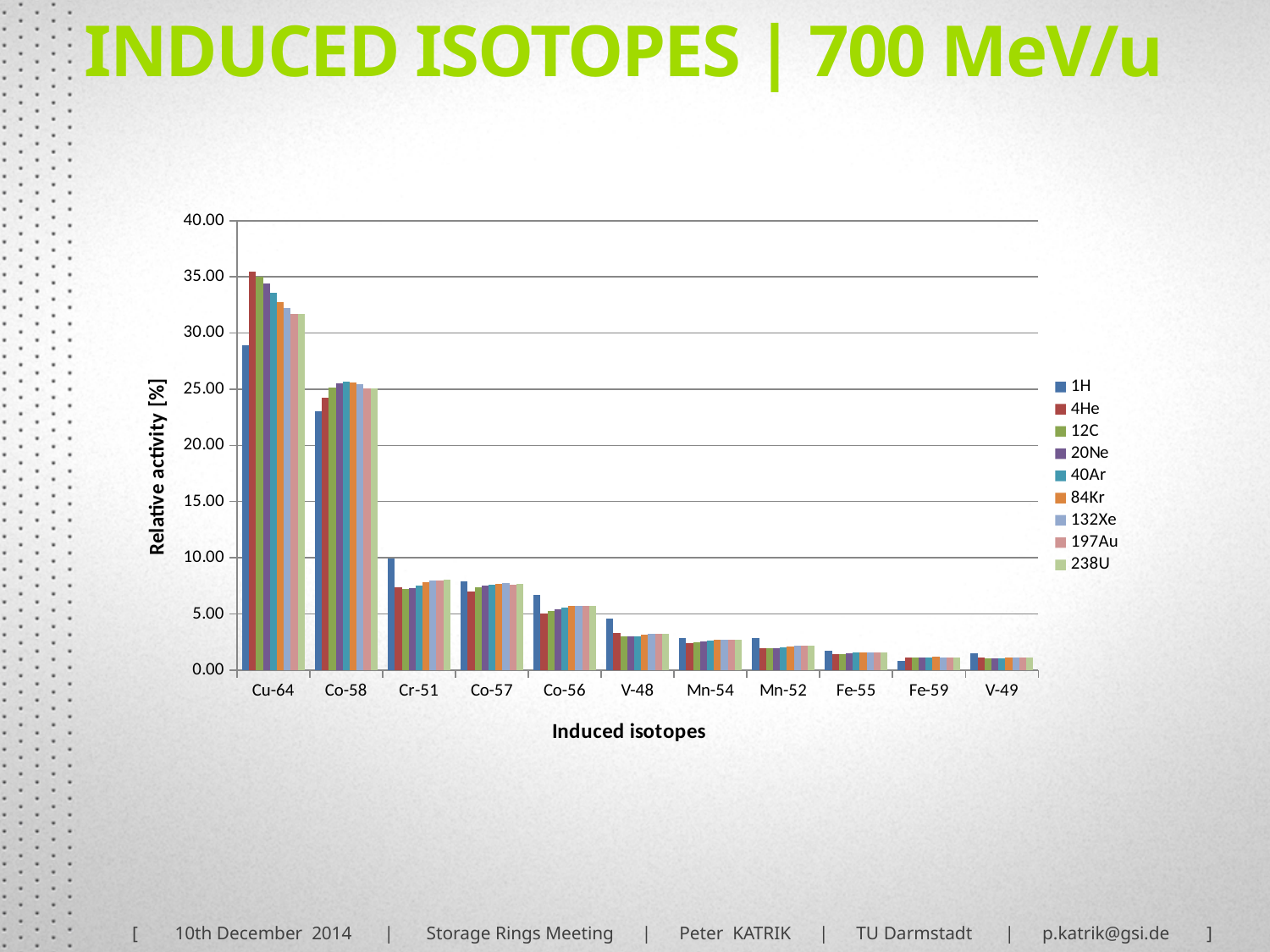
Is the relative activity of Cr-51 for 1H greater or less than 5.00? greater How many series does the legend list? 9 Which induced isotope has the highest relative activity? Cu-64 For the 1H series, which has the larger relative activity, Cu-64 or Co-58? Cu-64 Is the relative activity of Mn-54 for 4He greater or less than 5.00? less Do the relative activity values generally rise or fall from Cu-64 to V-49 along the x axis? fall What kind of chart is shown on the slide? bar chart How many induced isotopes are shown on the x axis? 11 What is the label of the y axis? Relative activity [%] Which series is listed first in the legend? 1H Is the relative activity of Cu-64 for 238U greater or less than 30.00? greater